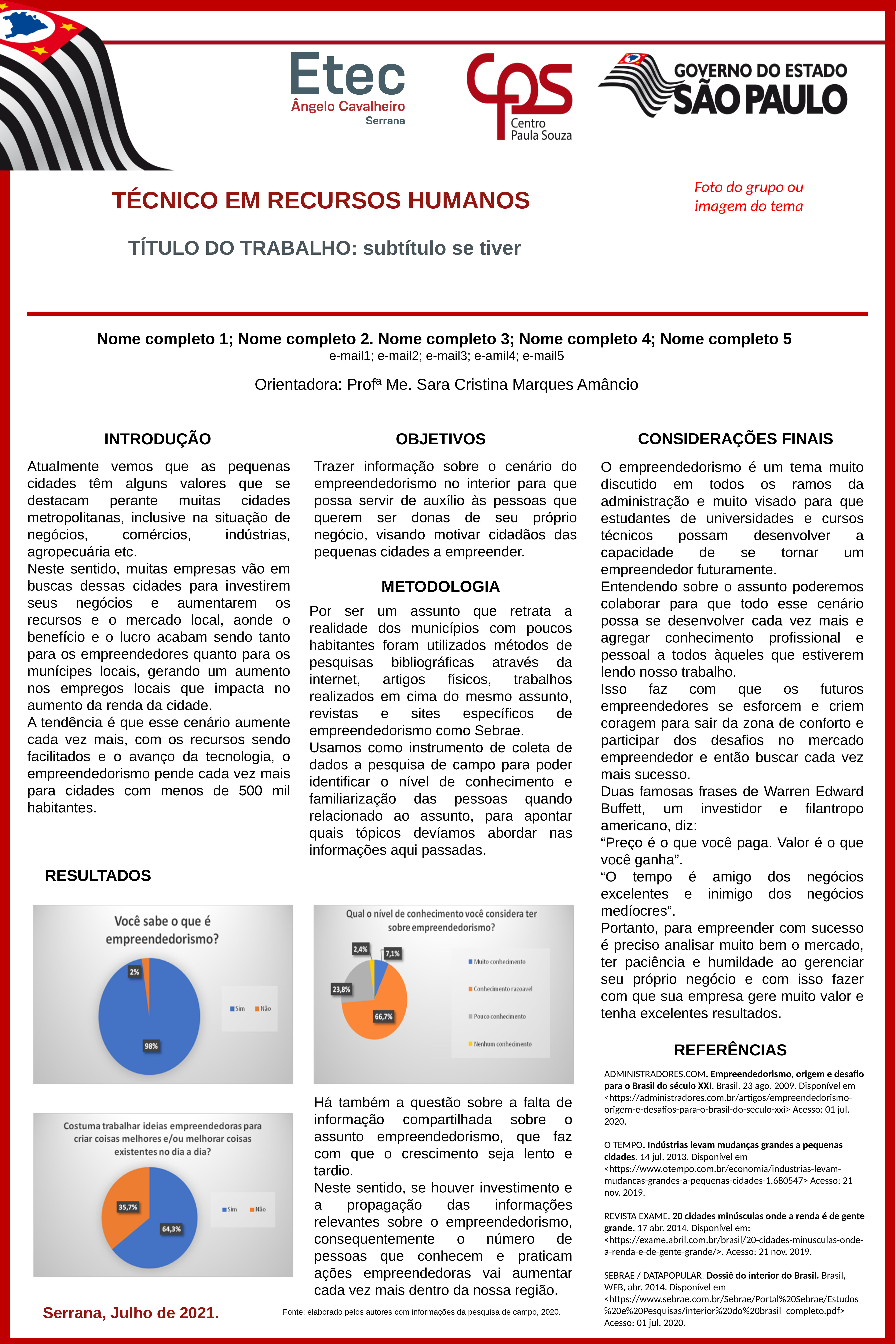
How many categories does the legend of the chart "Qual o nível de conhecimento você considera ter sobre empreendedorismo?" list? 4 In the chart titled "Você sabe o que é empreendedorismo?", what share of respondents answered "Sim"? 98% In the chart titled "Qual o nível de conhecimento você considera ter sobre empreendedorismo?", what is the value for "Pouco conhecimento"? 23,8% In the chart titled "Você sabe o que é empreendedorismo?", what share of respondents answered "Não"? 2% In the chart titled "Qual o nível de conhecimento você considera ter sobre empreendedorismo?", which category has the smallest share? Nenhum conhecimento In the chart titled "Qual o nível de conhecimento você considera ter sobre empreendedorismo?", what is the value for "Conhecimento razoável"? 66,7% In the chart titled "Qual o nível de conhecimento você considera ter sobre empreendedorismo?", what is the difference between "Muito conhecimento" and "Nenhum conhecimento"? 4,7% In the chart titled "Costuma trabalhar ideias empreendedoras para criar coisas melhores e/ou melhorar coisas existentes no dia a dia?", what share answered "Sim"? 64,3% In the chart titled "Costuma trabalhar ideias empreendedoras para criar coisas melhores e/ou melhorar coisas existentes no dia a dia?", which answer is larger, "Sim" or "Não"? Sim In the chart titled "Costuma trabalhar ideias empreendedoras para criar coisas melhores e/ou melhorar coisas existentes no dia a dia?", what is the difference between "Sim" and "Não"? 28,6% What kind of chart is "Você sabe o que é empreendedorismo?"? Pie chart In the chart titled "Qual o nível de conhecimento você considera ter sobre empreendedorismo?", which category has the largest share? Conhecimento razoável